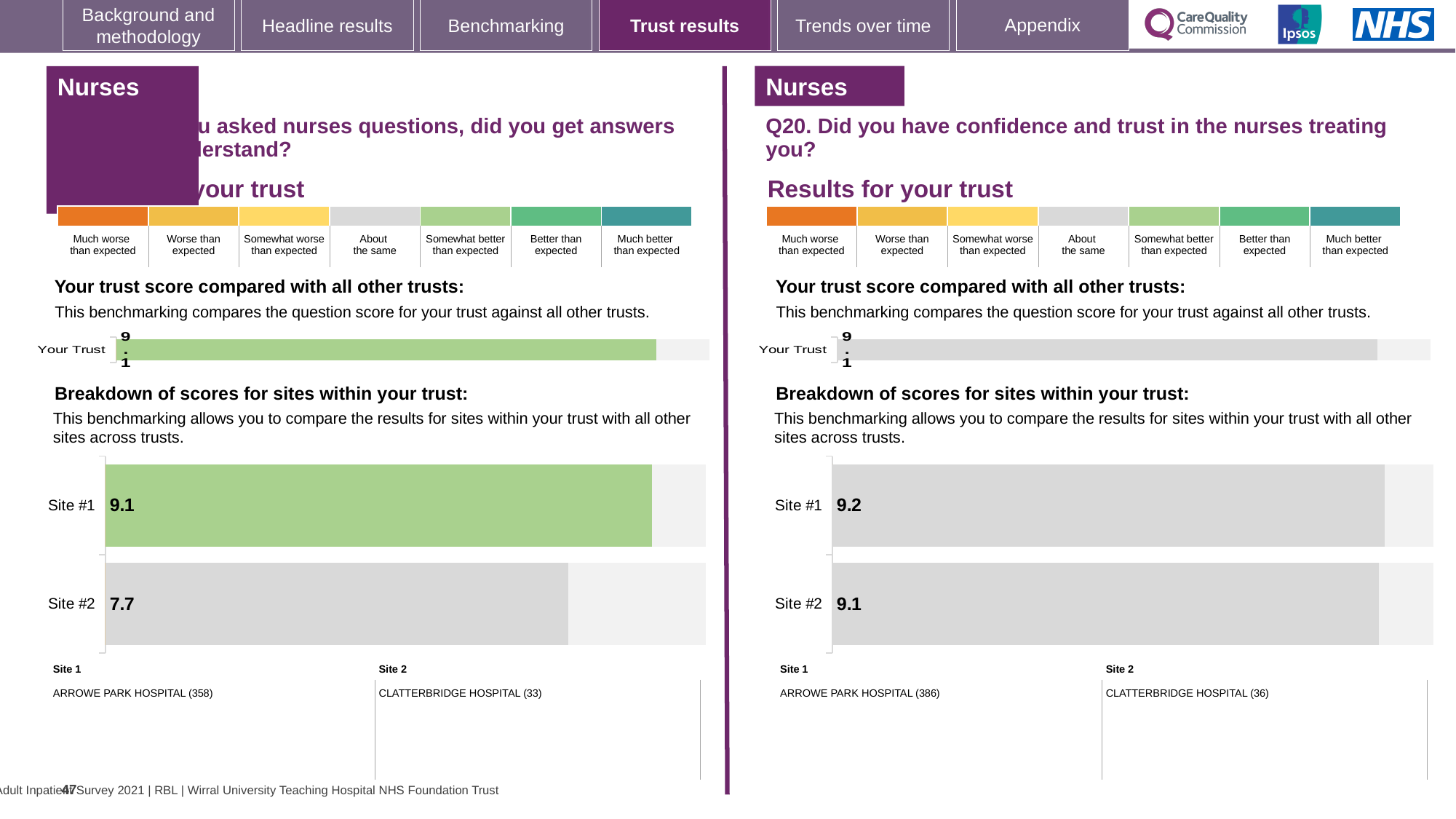
On the left-hand site breakdown chart, which site has the lowest score? Site #2 On the left-hand chart, what is the score shown for Your Trust in the comparison with all other trusts? 9.1 On the left-hand site breakdown chart, what is the difference between the Site #1 and Site #2 scores? 1.4 On the Q20 chart on the right, what is the difference between the Site #1 and Site #2 scores? 0.1 How many sites are shown in the site breakdown chart on the right (Q20)? 2 On the left-hand chart, what is the score for Site #2 in the breakdown of scores for sites within your trust? 7.7 On the left-hand chart, what is the score for Site #1 in the breakdown of scores for sites within your trust? 9.1 On the Q20 chart on the right, what is the score for Site #1 in the breakdown of scores for sites within your trust? 9.2 On the Q20 chart on the right, what is the score shown for Your Trust in the comparison with all other trusts? 9.1 On the left-hand site breakdown chart, which site has the higher score, Site #1 or Site #2? Site #1 What type of chart is used for the breakdown of scores for sites within your trust on the left? Bar chart On the Q20 chart on the right, what is the score for Site #2 in the breakdown of scores for sites within your trust? 9.1